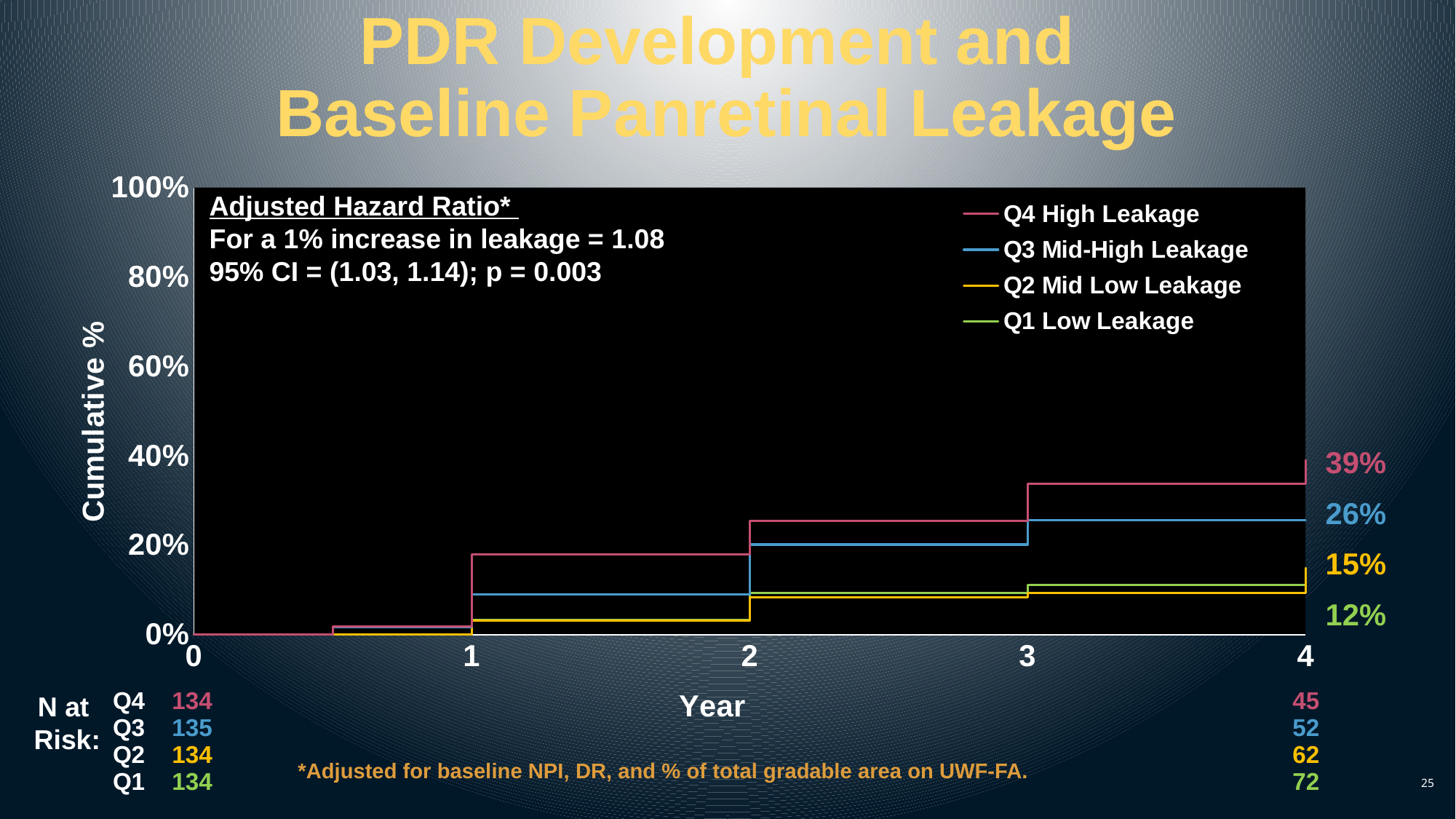
Do the cumulative percentages rise or fall as the years increase? rise How many series does the legend list? 4 What cumulative percentage is labelled for Q3 Mid-High Leakage at year 4? 26% What is the number at risk for Q4 at year 4? 45 What is the difference between the year-4 values for Q4 High Leakage and Q3 Mid-High Leakage? 13% Which series has the highest cumulative percentage at year 4? Q4 High Leakage Which is larger at year 4, Q4 High Leakage or Q3 Mid-High Leakage? Q4 High Leakage What cumulative percentage is labelled for Q4 High Leakage at year 4? 39% Is the value for Q4 High Leakage just after year 2 greater or less than 20%? greater What kind of chart is shown on the slide? line chart What is the number at risk for Q3 at year 0? 135 What is the label on the y axis? Cumulative %